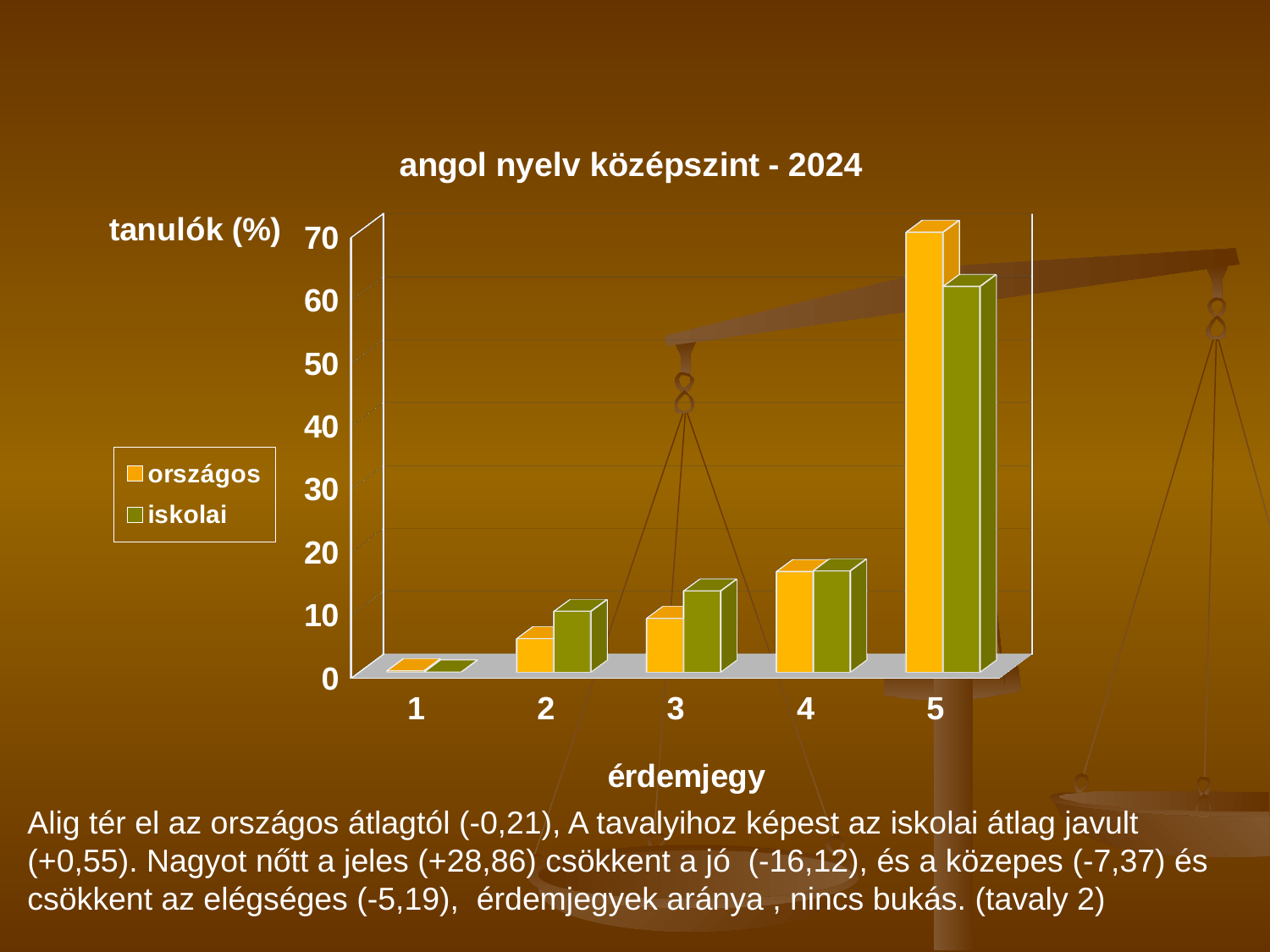
Is the országos value for grade 5 greater or less than 60? greater Is the iskolai value for grade 2 greater or less than 20? less How many grade categories (érdemjegy) are shown on the x axis? 5 For grade 5, which series has the larger value, országos or iskolai? országos Is the iskolai value for grade 5 greater or less than 50? greater What kind of chart is shown on the slide? bar chart Which grade has the lowest value for the iskolai series? 1 For grade 2, which series has the larger value, országos or iskolai? iskolai Which grade has the highest value for the országos series? 5 How many series does the legend list? 2 Do the országos values rise or fall as the grade increases from 1 to 5? rise What is the title of the chart? angol nyelv középszint - 2024